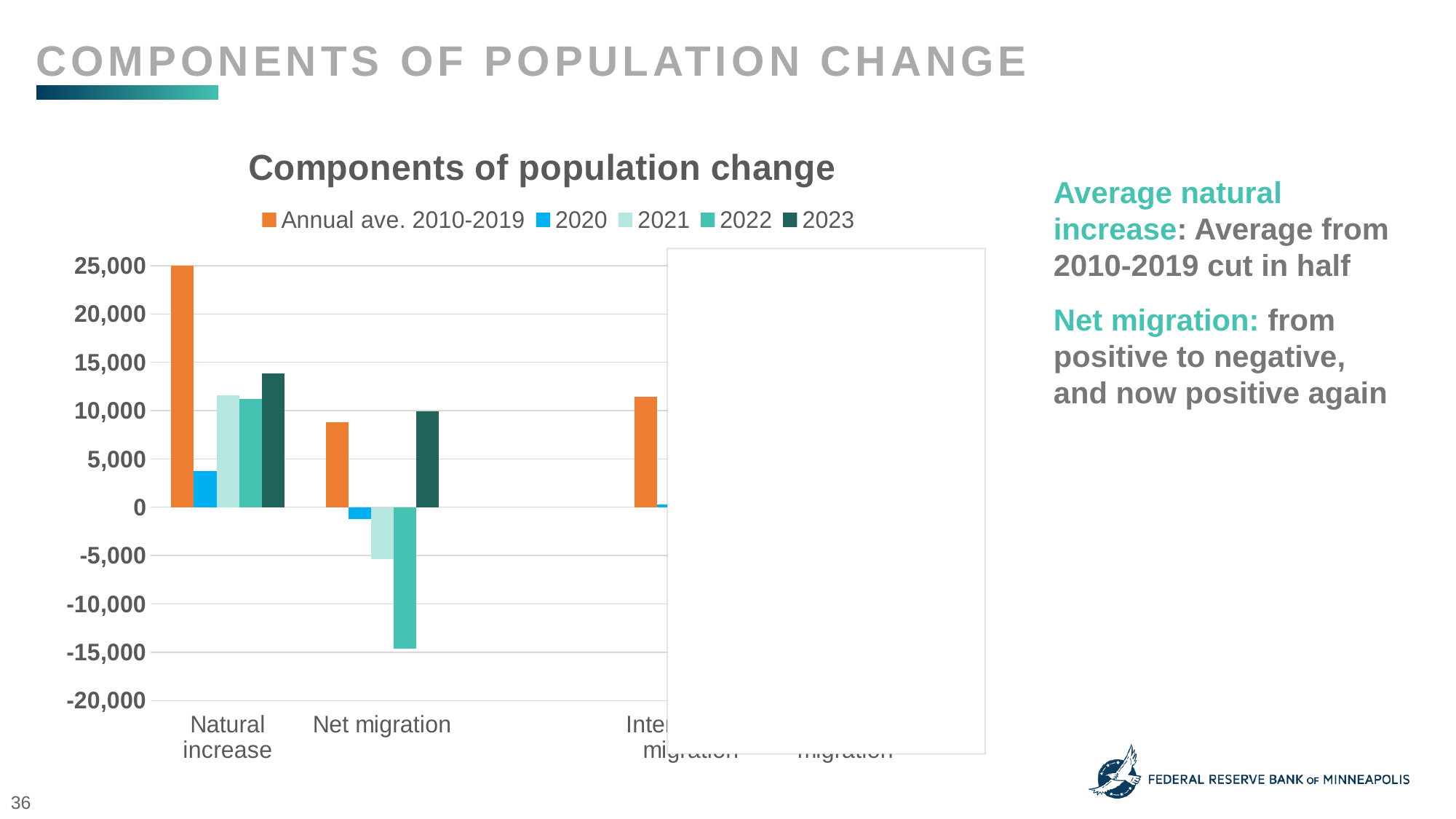
How many series does the chart's legend list? 5 For Natural increase, which series has the highest value? Annual ave. 2010-2019 Is the 2022 value for Net migration greater or less than -10,000? less For Net migration, which series has the lowest value? 2022 What kind of chart is shown on the slide? bar chart What is the title of the chart? Components of population change Which series in the legend is shown in orange? Annual ave. 2010-2019 Is the Annual ave. 2010-2019 value for Natural increase greater or less than 20,000? greater Is the 2020 value for Natural increase greater or less than 5,000? less For Natural increase, which is larger: the 2021 value or the 2023 value? 2023